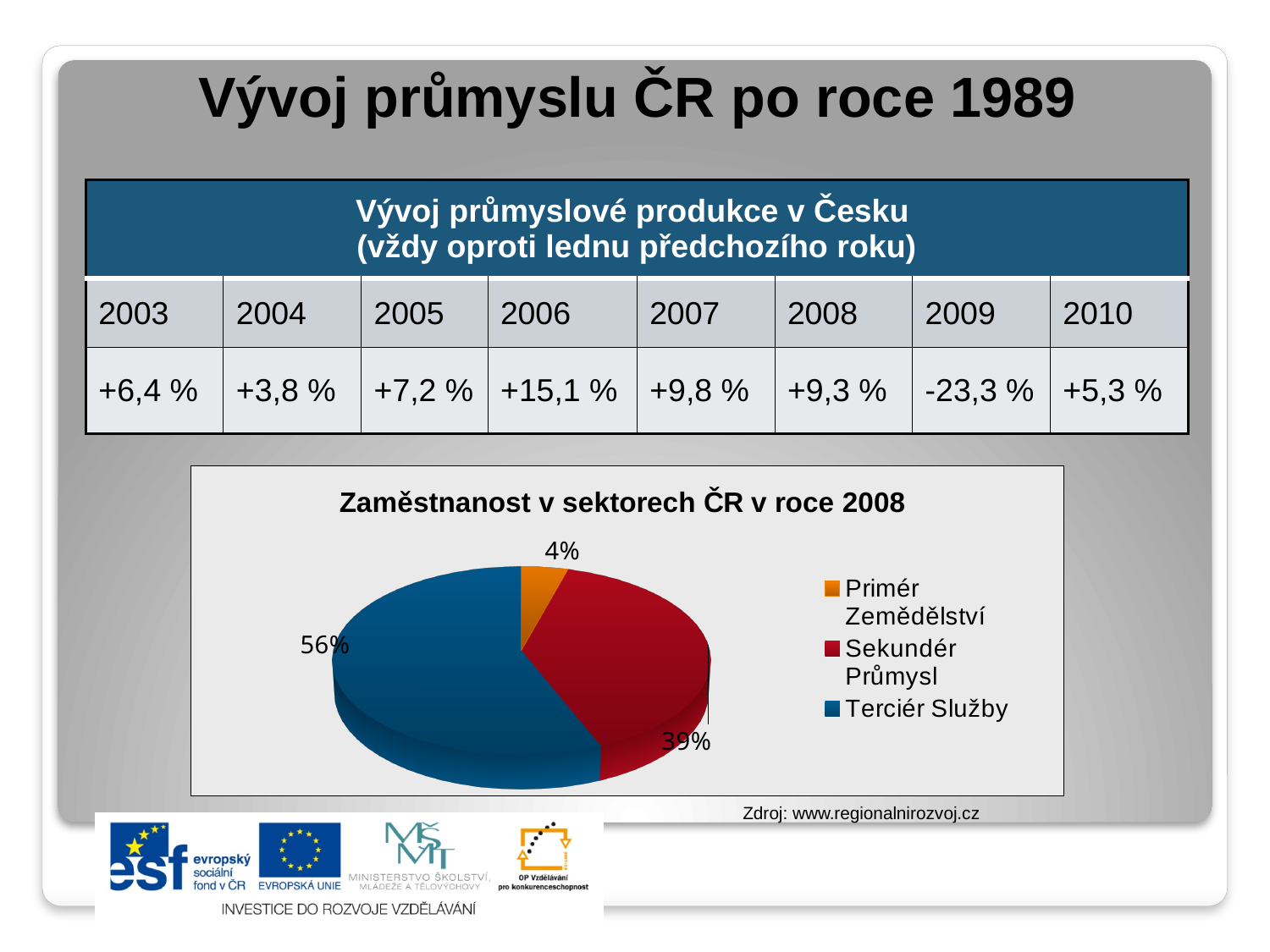
Which sector has the largest slice of the pie? Terciér Služby What share of the pie does Terciér Služby have? 56% What kind of chart is shown on the slide? pie chart What is the difference in percentage points between the Terciér Služby slice and the Sekundér Průmysl slice? 17 How many entries does the legend of the pie chart list? 3 How many slices does the pie chart have? 3 Which slice is larger, Sekundér Průmysl or Primér Zemědělství? Sekundér Průmysl What is the title of the pie chart? Zaměstnanost v sektorech ČR v roce 2008 What share of the pie does Sekundér Průmysl have? 39% What share of the pie does Primér Zemědělství have? 4% Which sector has the smallest slice of the pie? Primér Zemědělství What colour is the Sekundér Průmysl slice in the pie chart? red